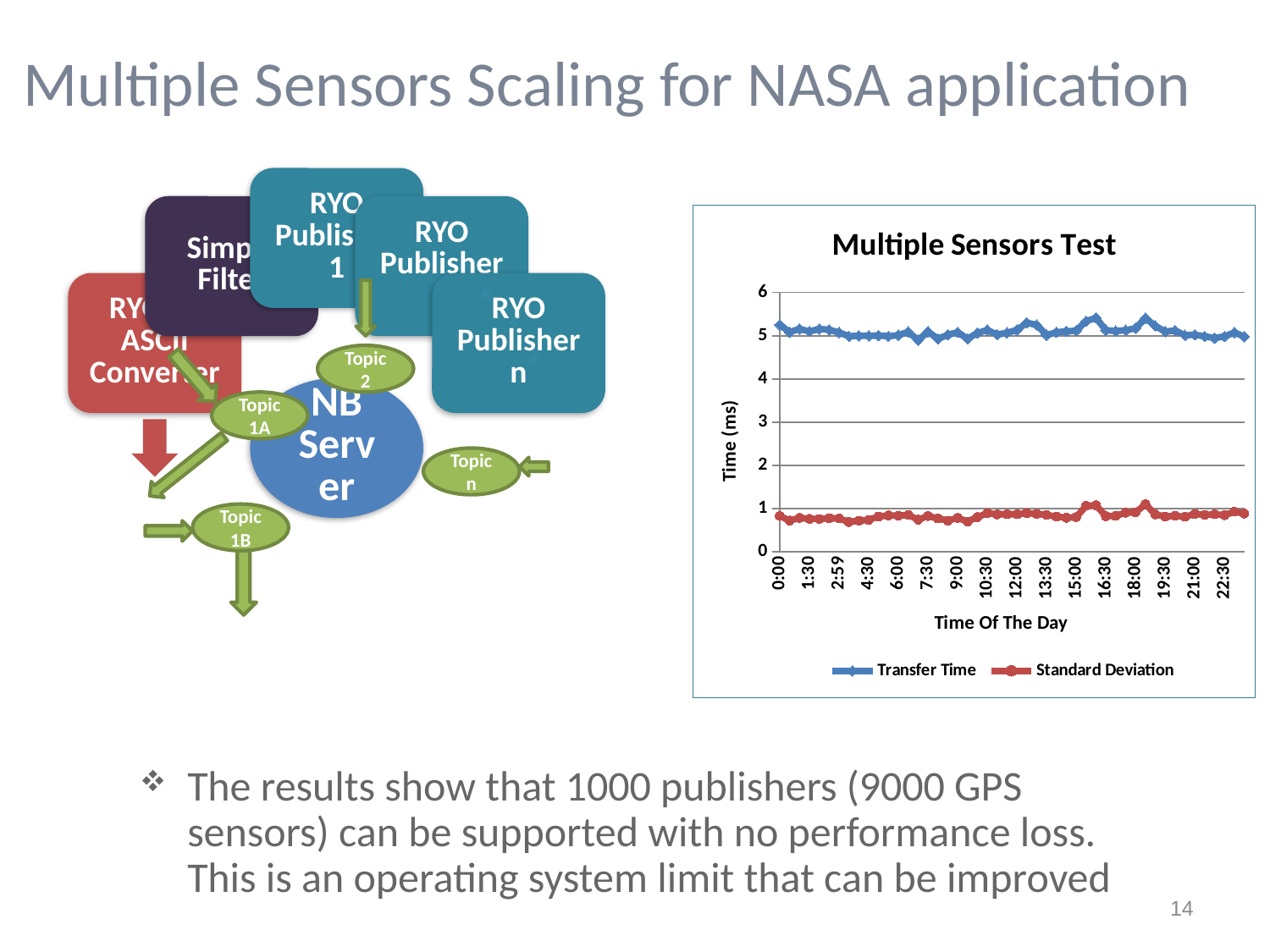
How many series does the legend of the chart list? 2 At 9:00, which series has the larger value, Transfer Time or Standard Deviation? Transfer Time Which series is plotted in blue in the chart? Transfer Time What is the title of the chart? Multiple Sensors Test Which series stays lower throughout the day, Transfer Time or Standard Deviation? Standard Deviation Is the Standard Deviation value at 16:30 greater or less than 3? less What is the label of the y axis of the chart? Time (ms) Is the Transfer Time value at 6:00 greater or less than 6? less Is the Transfer Time value at 0:00 greater or less than 4? greater Does the Transfer Time series rise sharply, fall sharply, or stay roughly flat across the day? roughly flat What kind of chart is shown on the slide? line chart